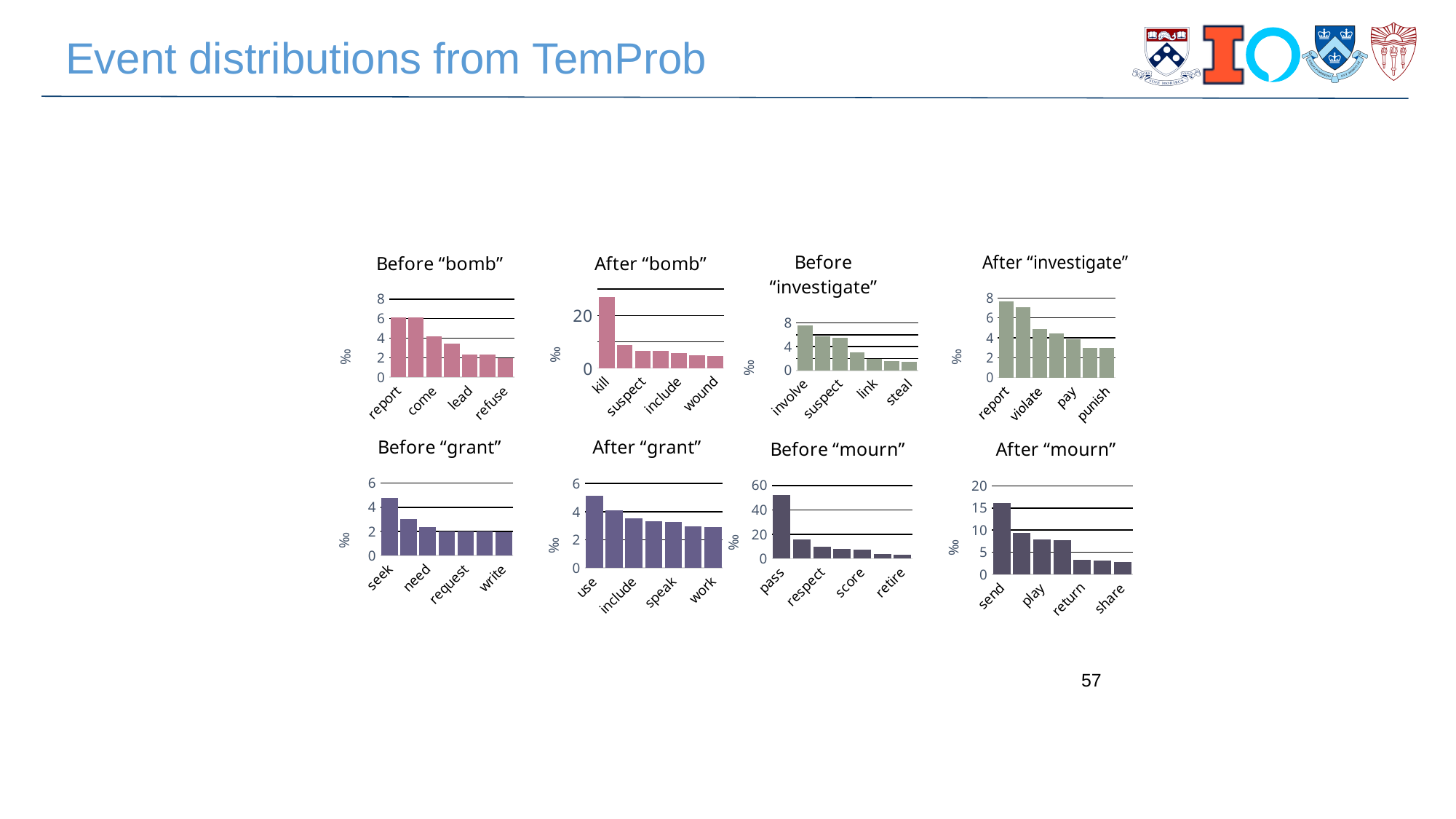
In the After "mourn" chart, which category has the highest value? send What kind of chart is used for Before "mourn"? bar chart In the Before "mourn" chart, is the value for pass greater or less than 40? greater In the Before "mourn" chart, is the value for respect greater or less than 20? less What unit is shown on the y axis of the Before "bomb" chart? ‰ In the After "bomb" chart, which category has the highest value? kill In the Before "grant" chart, which category has the highest value? seek In the Before "investigate" chart, is the value for involve greater or less than 6? greater In the After "mourn" chart, which is larger, the value for send or the value for play? send In the After "grant" chart, do the values rise or fall from left to right along the x axis? fall